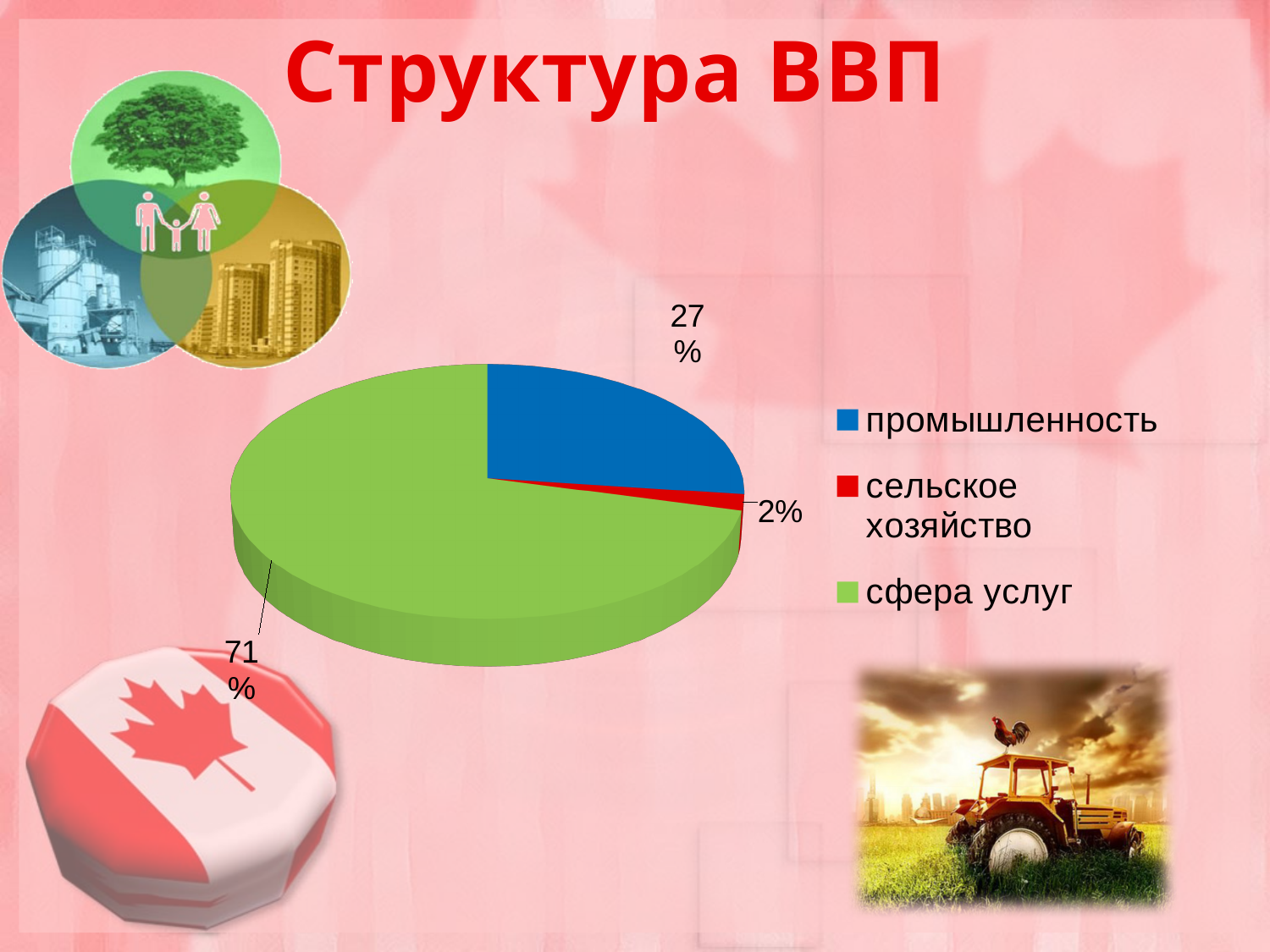
What colour is the slice for сфера услуг? green How many slices does the pie chart have? 3 Which category has the largest slice of the pie? сфера услуг What is the title of the chart on the slide? Структура ВВП What share of the pie does сфера услуг have? 71% How many entries does the legend list? 3 What share of the pie does сельское хозяйство have? 2% What share of the pie does промышленность have? 27% What is the difference between the shares of сфера услуг and промышленность? 44% What kind of chart is shown on the slide? pie chart Which category has the smallest slice of the pie? сельское хозяйство Which is larger, the share of промышленность or the share of сельское хозяйство? промышленность